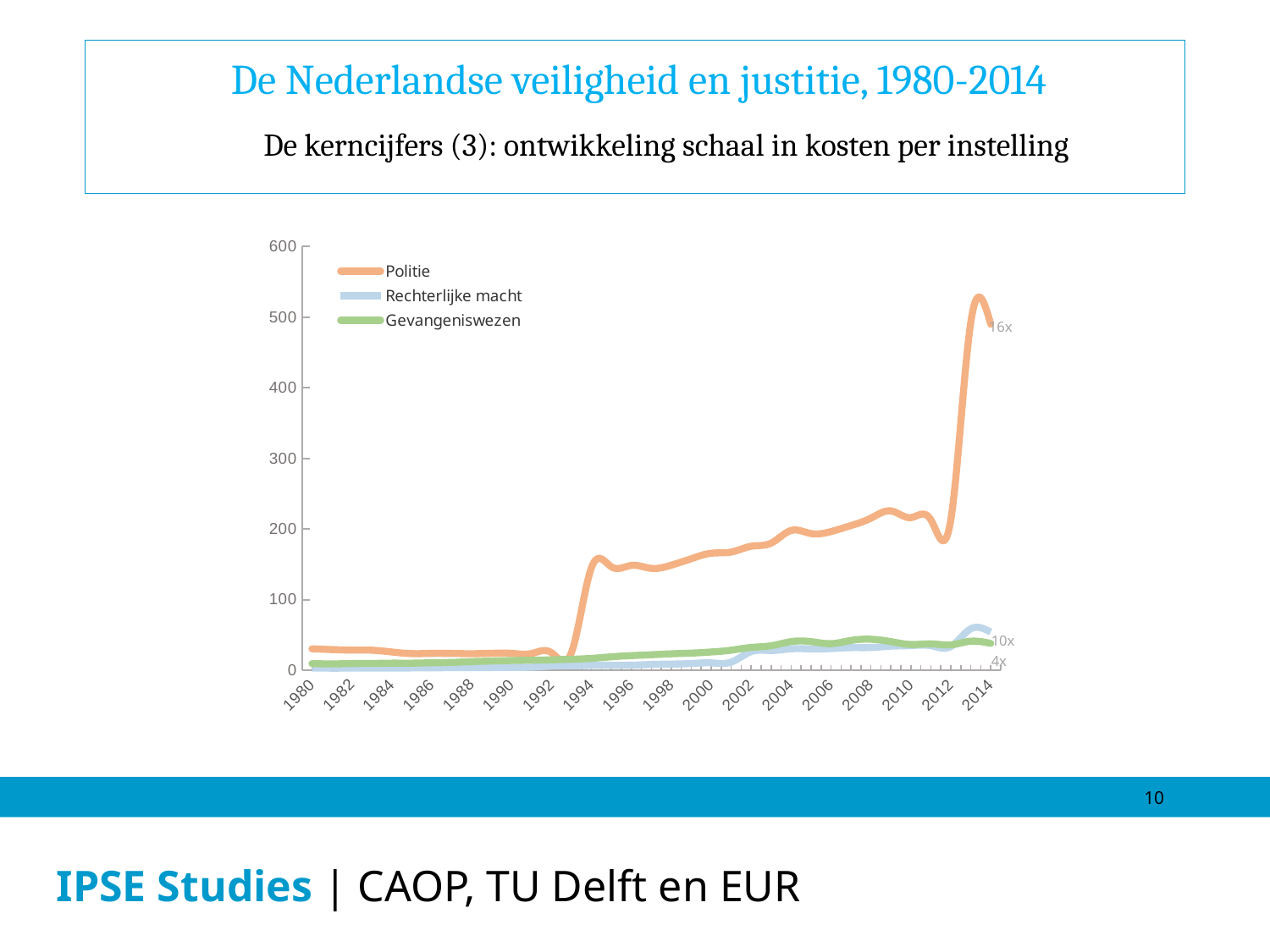
What multiplier is annotated at the end of the Rechterlijke macht line? 10x How many series does the legend list? 3 Is the value for Politie in 1990 greater or less than 100? less Which series has the lowest value in 2014? Gevangeniswezen Does the Politie line overall rise or fall from 1980 to 2014? rise Which series has the highest value in 2014? Politie What multiplier is annotated at the end of the Gevangeniswezen line? 4x Is the value for Politie in 2000 greater or less than 100? greater Is the value for Politie in 2013 greater or less than 400? greater Which series are listed in the legend? Politie, Rechterlijke macht, Gevangeniswezen What multiplier is annotated at the end of the Politie line? 16x What kind of chart is shown on the slide? line chart